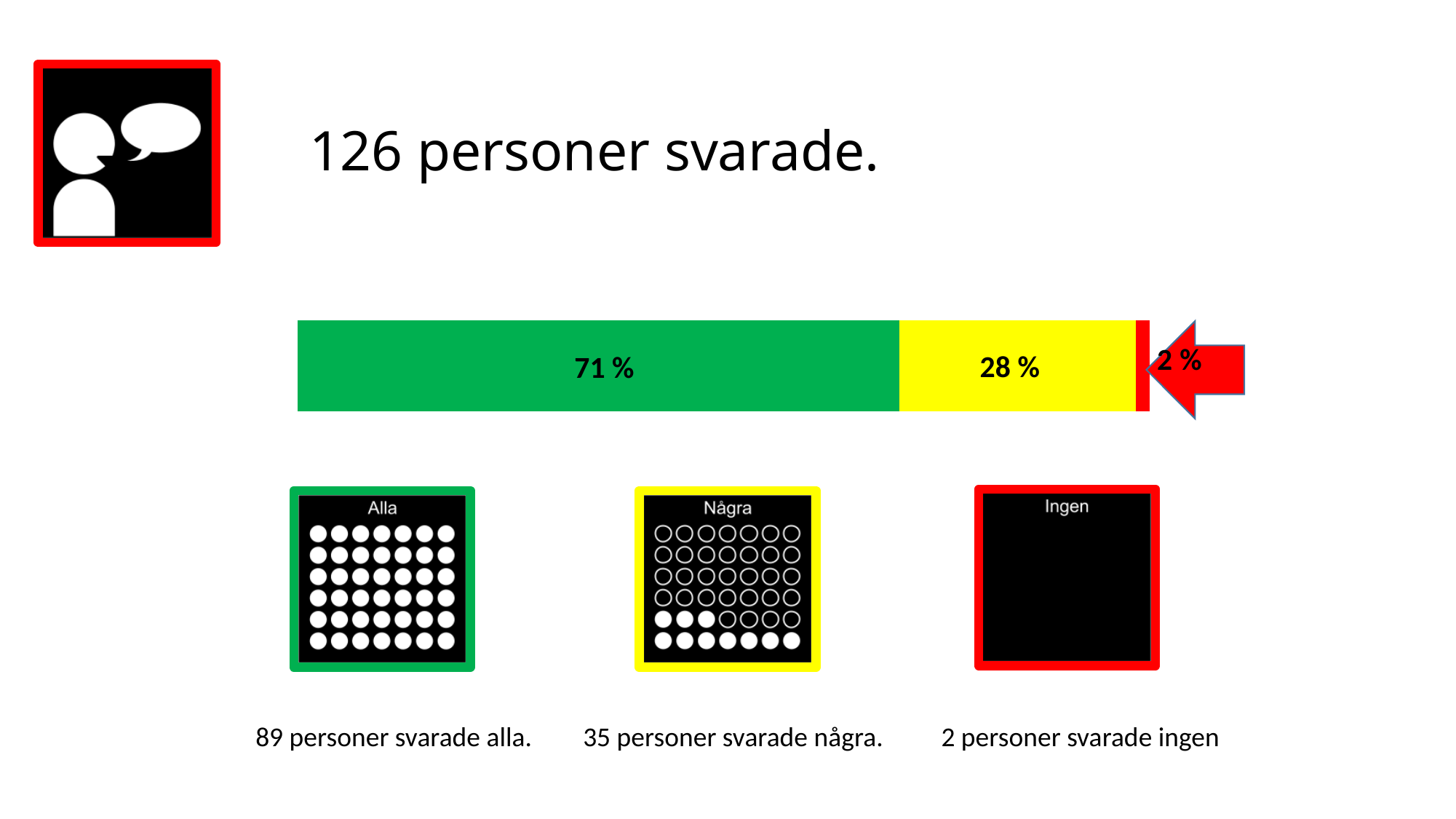
How many people answered 'alla' according to the text below the chart? 89 What kind of chart is shown on the slide? A stacked bar chart Which segment of the bar has the smallest share? 2 % (red, Ingen) Which is larger, the yellow segment or the red segment? The yellow segment (28 %) What is the difference in percentage points between the green segment and the yellow segment? 43 What percentage is shown on the green segment of the bar? 71 % How many segments does the bar have? 3 What colour is the segment labelled 28 %? Yellow What percentage is shown on the yellow segment of the bar? 28 % What percentage is shown next to the red segment of the bar? 2 % How many people answered in total, according to the slide title? 126 Which segment of the bar has the largest share? 71 % (green, Alla)